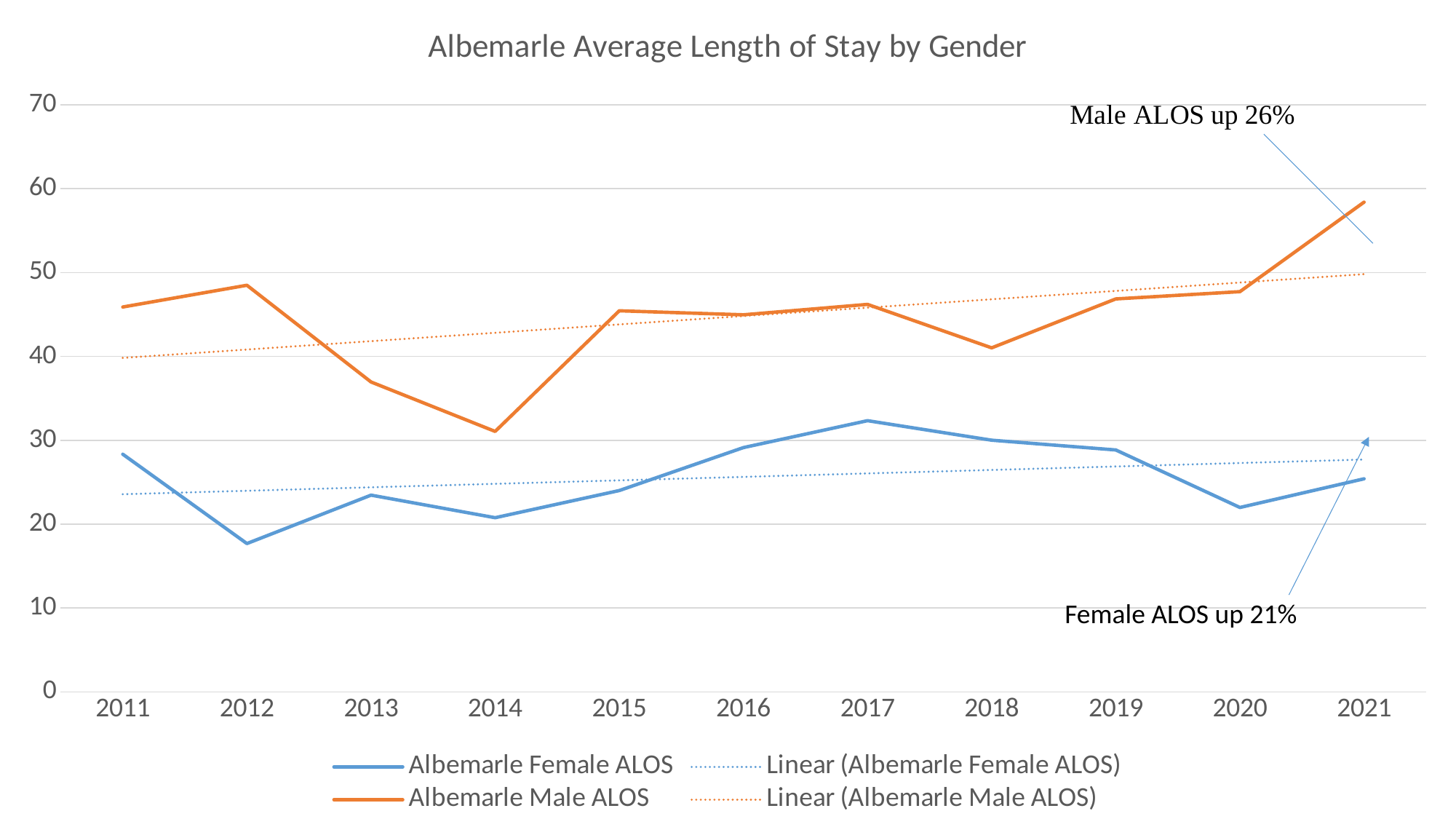
Does the Linear (Albemarle Male ALOS) trendline rise or fall from 2011 to 2021? rise How many series does the legend list? 4 In which year is the Albemarle Female ALOS lowest? 2012 Is the Albemarle Male ALOS value for 2021 greater or less than 50? greater How many years are plotted along the x axis? 11 Is the Albemarle Female ALOS value for 2012 greater or less than 20? less According to the annotation on the chart, by what percentage is Male ALOS up? 26% In which year is the Albemarle Female ALOS highest? 2017 In 2021, which is larger: the Albemarle Male ALOS or the Albemarle Female ALOS? Albemarle Male ALOS In which year is the Albemarle Male ALOS highest? 2021 What kind of chart is shown on the slide? line chart In which year is the Albemarle Male ALOS lowest? 2014